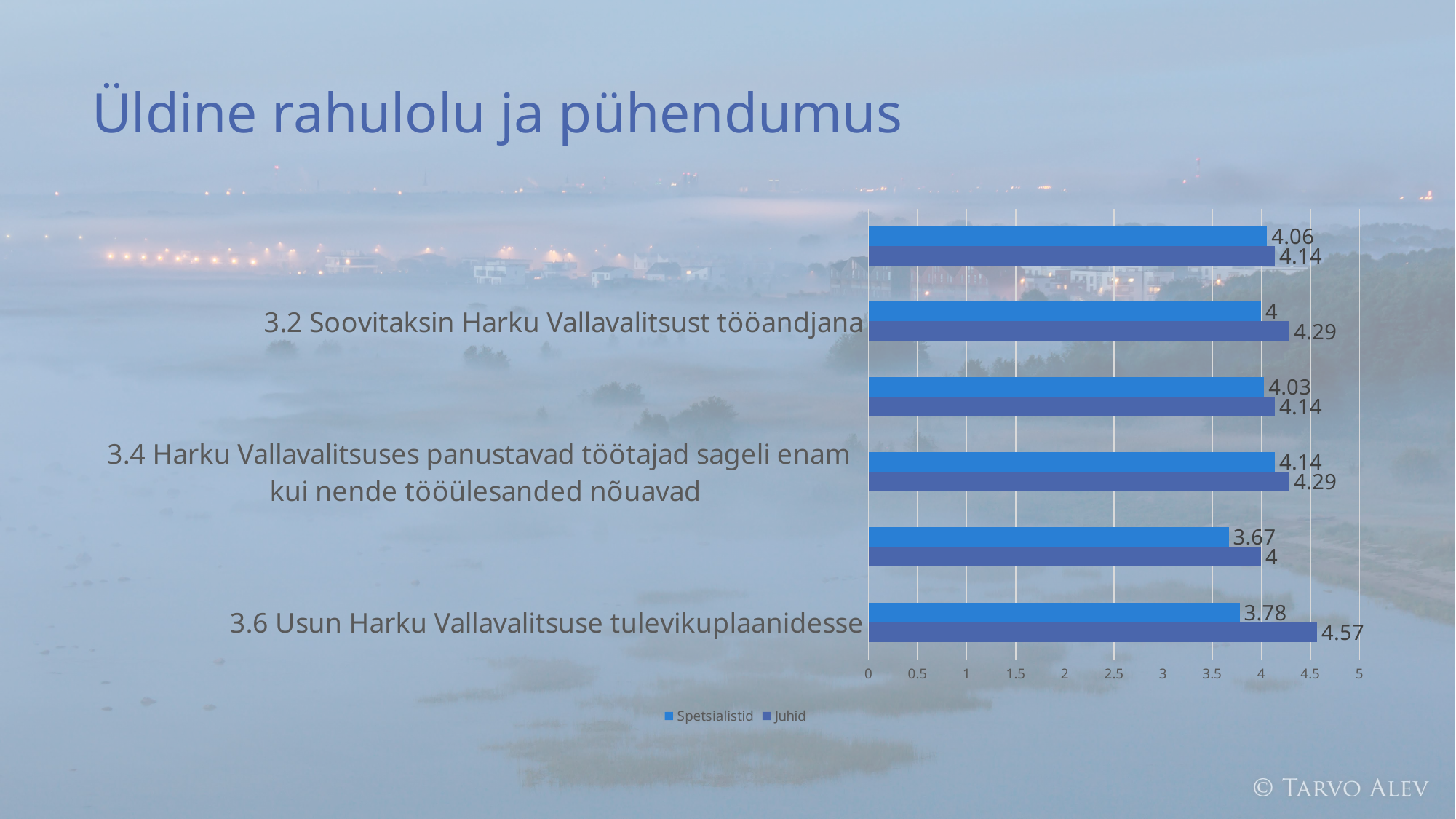
Which labelled category has the highest Juhid value? 3.6 Usun Harku Vallavalitsuse tulevikuplaanidesse What kind of chart is shown on the slide? bar chart What is the Spetsialistid value for "3.2 Soovitaksin Harku Vallavalitsust tööandjana"? 4 What is the difference between the Juhid and Spetsialistid values for "3.6 Usun Harku Vallavalitsuse tulevikuplaanidesse"? 0.79 For "3.2 Soovitaksin Harku Vallavalitsust tööandjana", which series has the larger value, Spetsialistid or Juhid? Juhid What is the title of the slide? Üldine rahulolu ja pühendumus Is the Spetsialistid value for "3.6 Usun Harku Vallavalitsuse tulevikuplaanidesse" greater or less than 4? less What is the Juhid value for "3.4 Harku Vallavalitsuses panustavad töötajad sageli enam kui nende tööülesanded nõuavad"? 4.29 What is the Juhid value for "3.2 Soovitaksin Harku Vallavalitsust tööandjana"? 4.29 What is the Spetsialistid value for "3.6 Usun Harku Vallavalitsuse tulevikuplaanidesse"? 3.78 What is the Juhid value for "3.6 Usun Harku Vallavalitsuse tulevikuplaanidesse"? 4.57 How many series does the legend list? 2